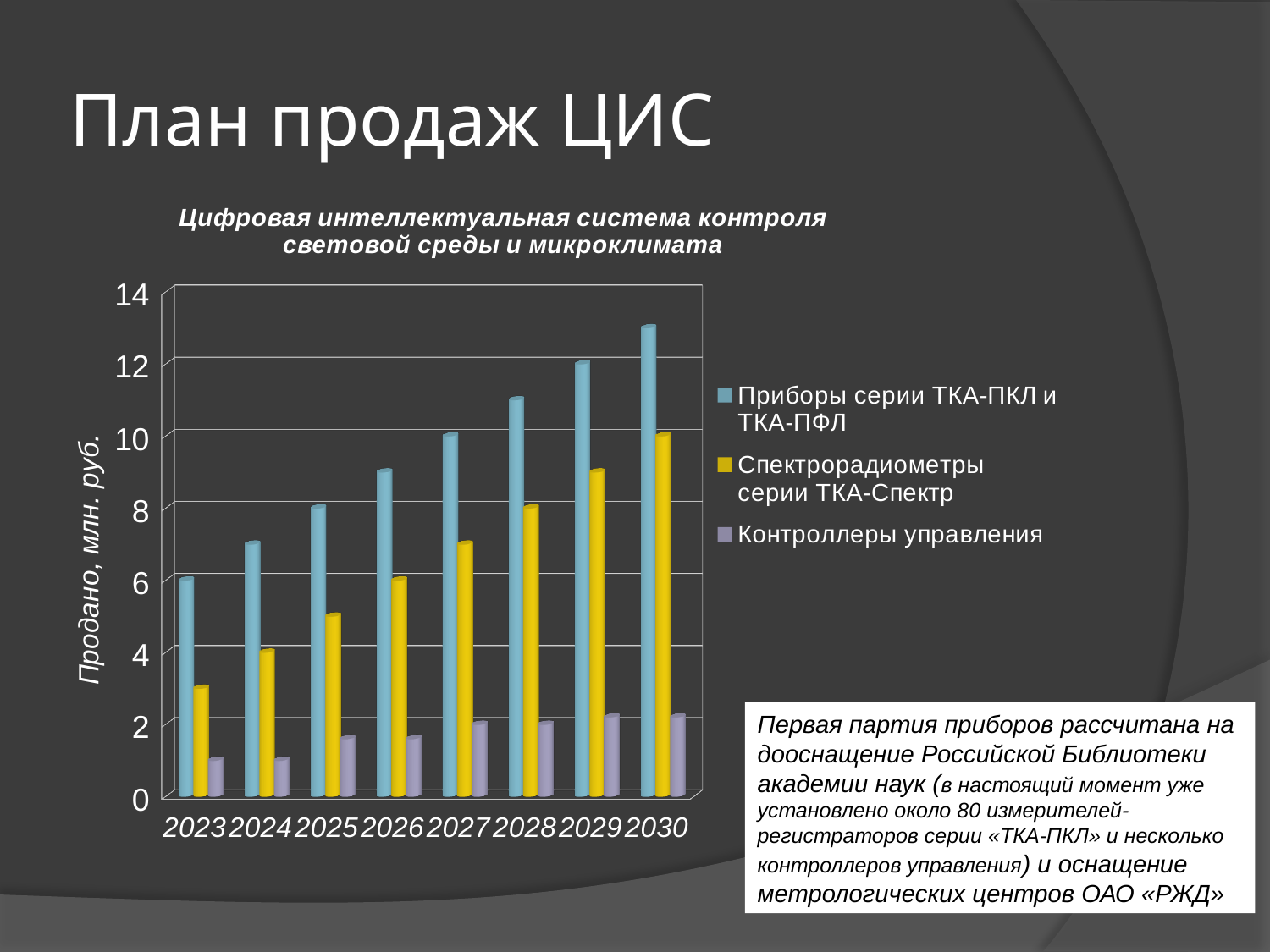
Do the values for Спектрорадиометры серии ТКА-Спектр rise or fall from 2023 to 2030? rise What is the label of the vertical axis? Продано, млн. руб. Which year has the highest value for Приборы серии ТКА-ПКЛ и ТКА-ПФЛ? 2030 What is the value for Спектрорадиометры серии ТКА-Спектр in 2026? 6 What is the value for Приборы серии ТКА-ПКЛ и ТКА-ПФЛ in 2023? 6 What kind of chart is shown on the slide? bar chart How many years are shown on the x axis? 8 Is the value for Контроллеры управления in 2023 greater or less than 2? less What is the value for Спектрорадиометры серии ТКА-Спектр in 2030? 10 Is the value for Приборы серии ТКА-ПКЛ и ТКА-ПФЛ in 2030 greater or less than 12? greater How many series does the legend list? 3 What is the value for Приборы серии ТКА-ПКЛ и ТКА-ПФЛ in 2029? 12